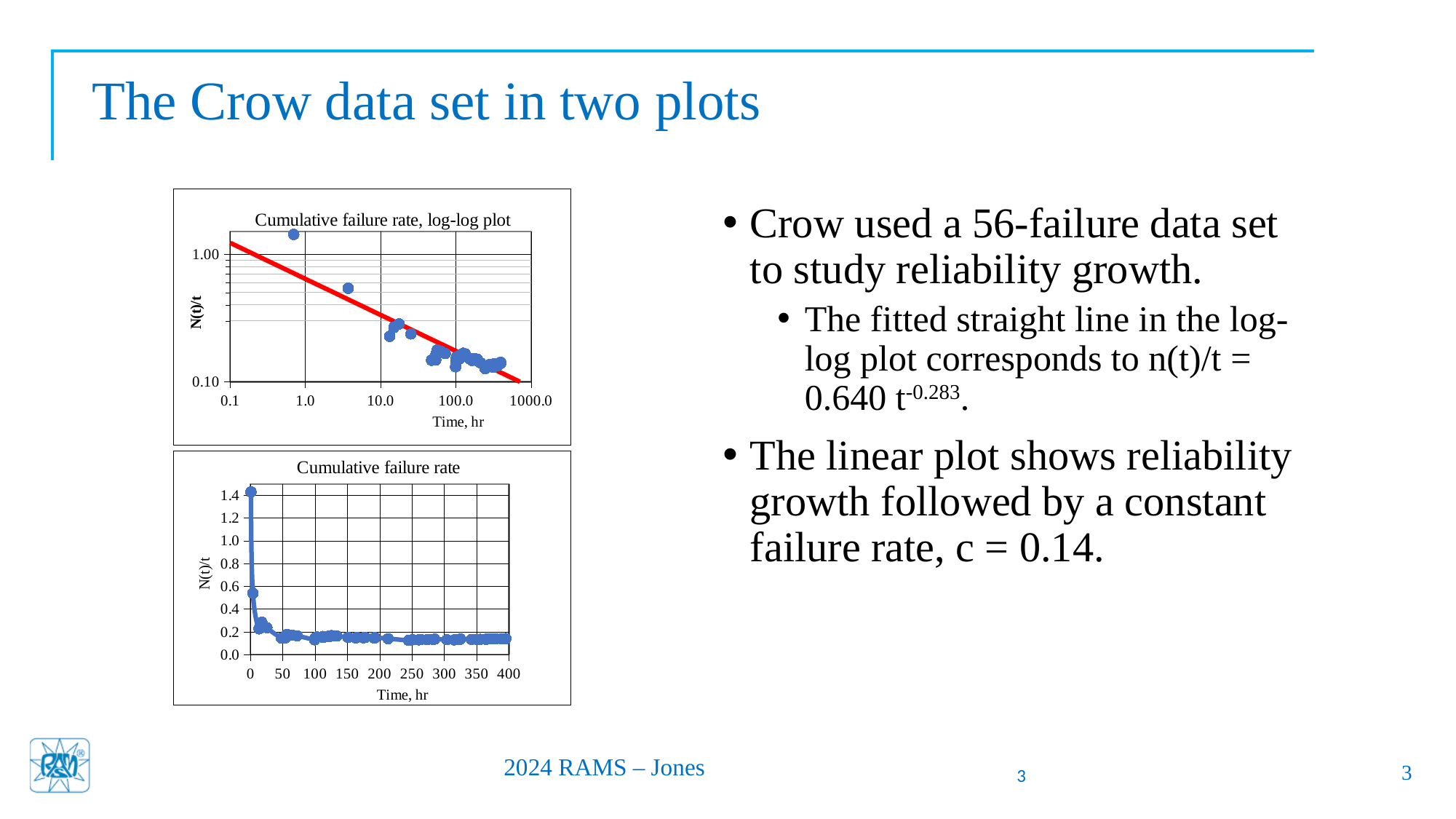
In the top chart "Cumulative failure rate, log-log plot", is the value at about 1.0 hr greater or less than 0.10? greater What is the y-axis label of the top chart "Cumulative failure rate, log-log plot"? N(t)/t In the bottom chart "Cumulative failure rate", which is larger: the value at 0 hr or the value at 400 hr? the value at 0 hr What kind of chart is the bottom chart titled "Cumulative failure rate"? scatter chart What is the x-axis label of the bottom chart "Cumulative failure rate"? Time, hr In the top chart "Cumulative failure rate, log-log plot", is the highest plotted point greater or less than 1.00? greater In the bottom chart "Cumulative failure rate", is the value at time 0 hr greater or less than 1.0? greater In the bottom chart "Cumulative failure rate", do the values rise or fall as time increases from 0 hr? fall In the top chart "Cumulative failure rate, log-log plot", do the plotted values rise or fall as time increases? fall What kind of chart is the top chart titled "Cumulative failure rate, log-log plot"? scatter chart